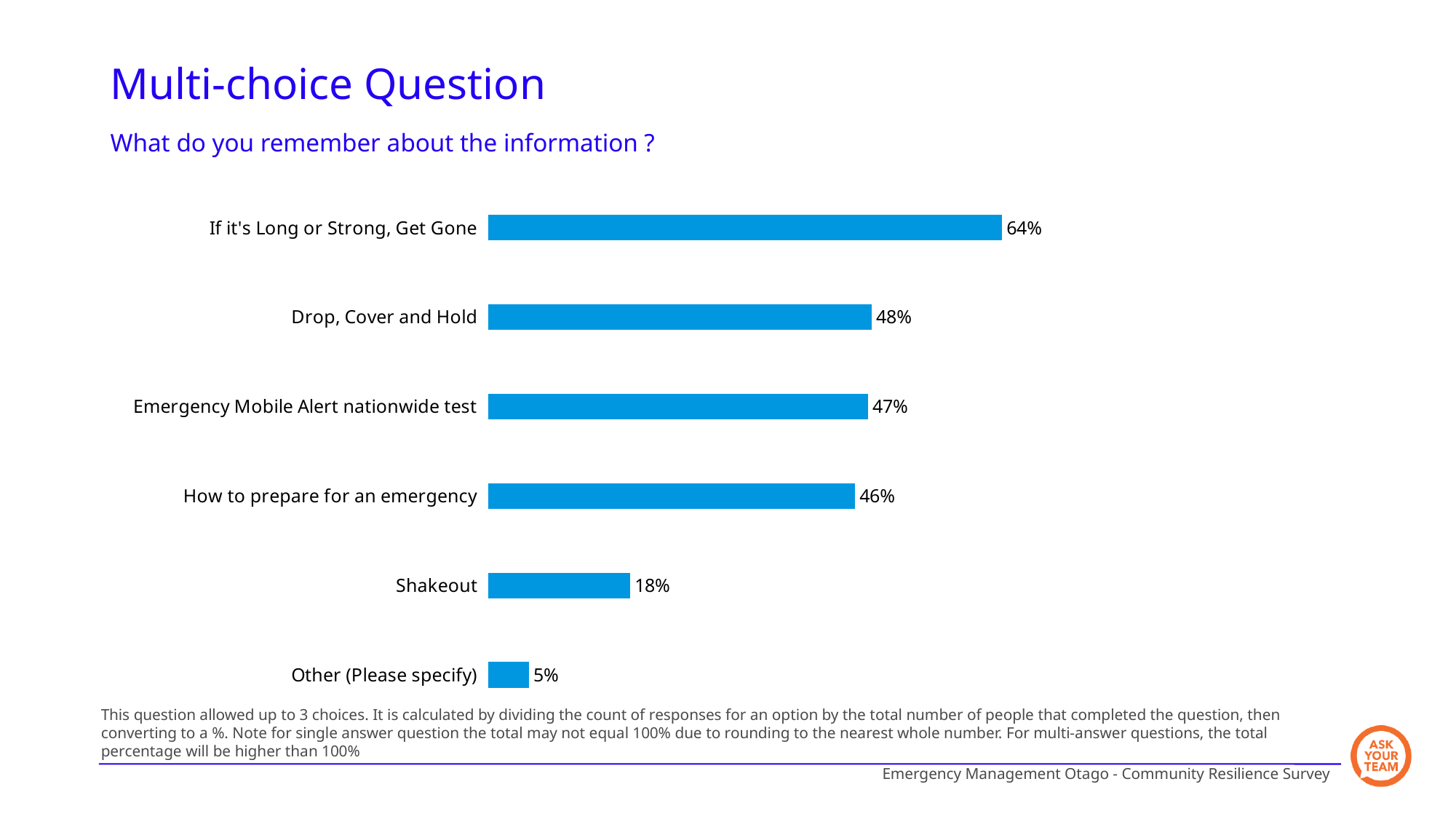
What type of chart is shown on the slide? Bar chart What question does the chart present results for? What do you remember about the information ? What is the value shown for "Drop, Cover and Hold"? 48% What is the difference in percentage points between "If it's Long or Strong, Get Gone" and "Drop, Cover and Hold"? 16 What percentage is shown for "Shakeout"? 18% What is the difference in percentage points between "Shakeout" and "Other (Please specify)"? 13 What percentage of respondents remembered "If it's Long or Strong, Get Gone"? 64% Which option has the highest percentage? If it's Long or Strong, Get Gone How many options are shown in the chart? 6 What is the value for "Other (Please specify)"? 5% Which has a higher value: "Emergency Mobile Alert nationwide test" or "Shakeout"? Emergency Mobile Alert nationwide test Which option has the lowest percentage? Other (Please specify)